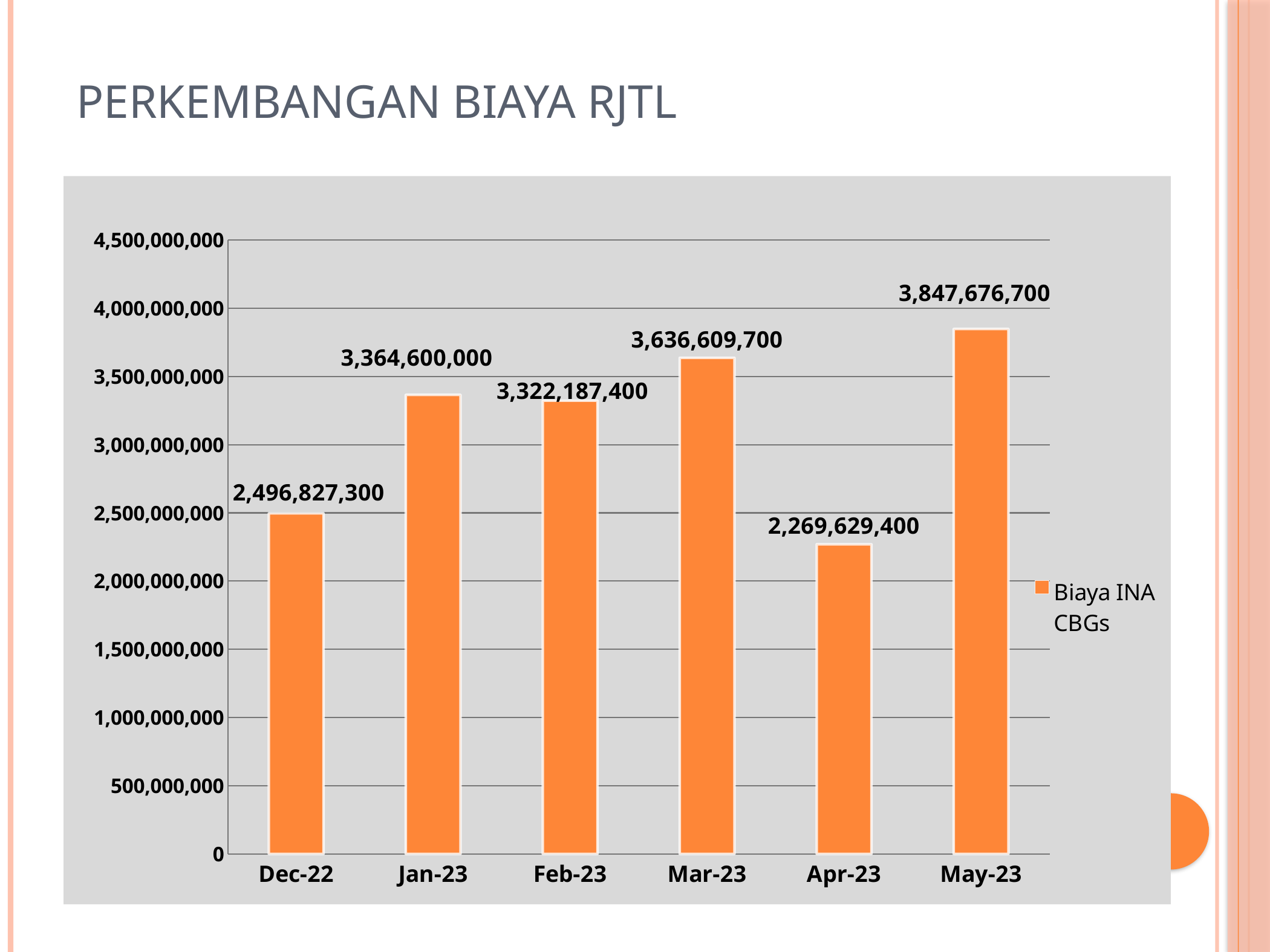
Which is larger, the value for Jan-23 or the value for Feb-23? Jan-23 What is the value for Dec-22? 2,496,827,300 Which month has the highest value? May-23 What kind of chart is shown on the slide? bar chart What is the value for Mar-23? 3,636,609,700 What is the difference between the values for May-23 and Apr-23? 1,578,047,300 What series name does the legend show? Biaya INA CBGs How many months are shown on the x axis? 6 What is the difference between the values for Jan-23 and Dec-22? 867,772,700 Is the value for Mar-23 greater or less than 3,500,000,000? greater What is the value for Apr-23? 2,269,629,400 Which month has the lowest value? Apr-23